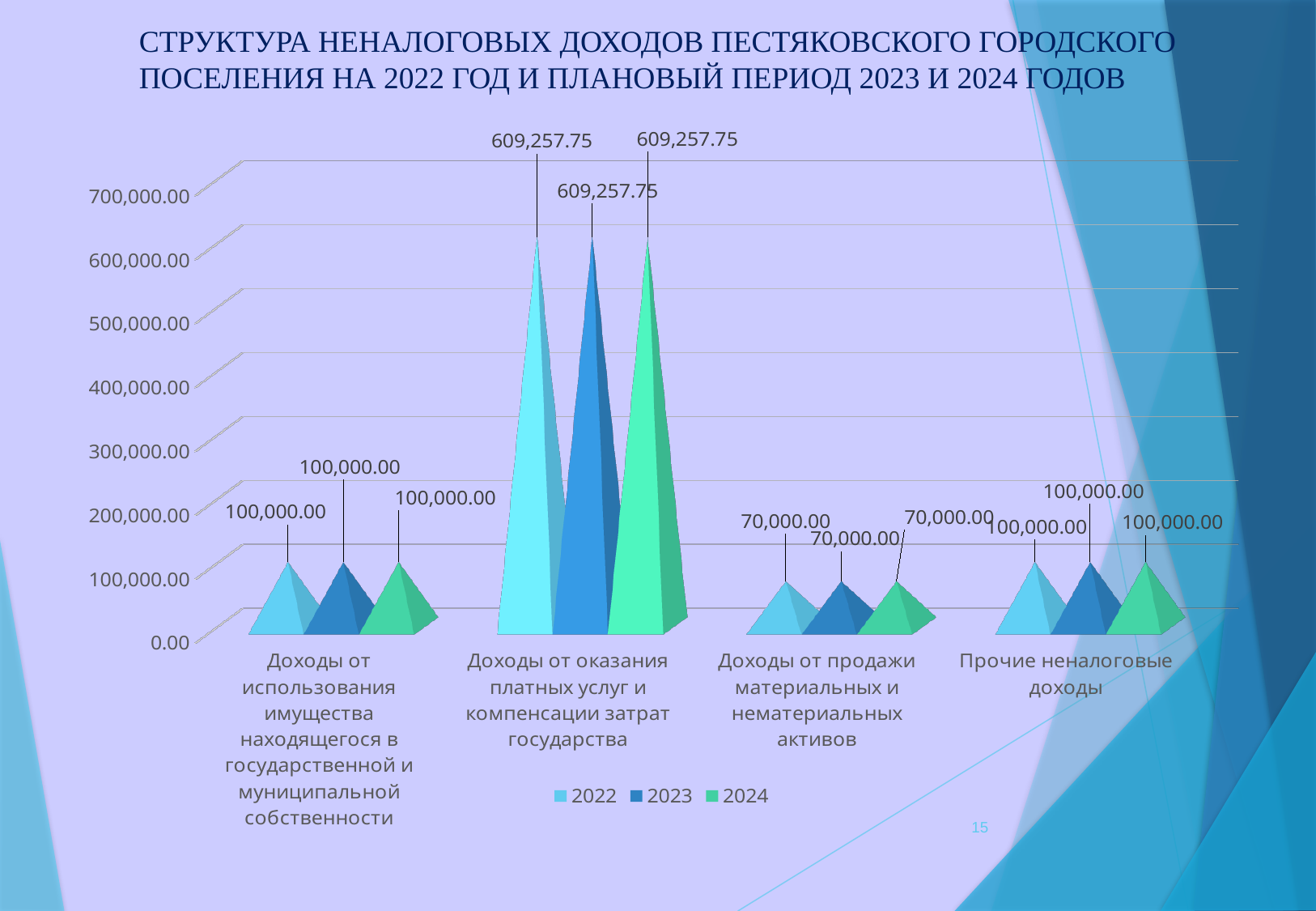
What is the value for 2022 for "Доходы от использования имущества находящегося в государственной и муниципальной собственности"? 100,000.00 What kind of chart is shown on the slide? Bar chart How many series does the legend list? 3 What is the value for 2022 for "Доходы от оказания платных услуг и компенсации затрат государства"? 609,257.75 Which is larger: the 2024 value for "Доходы от использования имущества находящегося в государственной и муниципальной собственности" or the 2024 value for "Доходы от продажи материальных и нематериальных активов"? Доходы от использования имущества находящегося в государственной и муниципальной собственности What is the value for 2024 for "Прочие неналоговые доходы"? 100,000.00 Which category has the highest value for 2023? Доходы от оказания платных услуг и компенсации затрат государства How many categories are shown on the x axis? 4 Which category has the lowest value for 2024? Доходы от продажи материальных и нематериальных активов What is the value for 2023 for "Доходы от продажи материальных и нематериальных активов"? 70,000.00 What is the difference between the 2023 value for "Прочие неналоговые доходы" and the 2023 value for "Доходы от продажи материальных и нематериальных активов"? 30,000.00 What is the difference between the 2022 value for "Доходы от оказания платных услуг и компенсации затрат государства" and the 2022 value for "Прочие неналоговые доходы"? 509,257.75